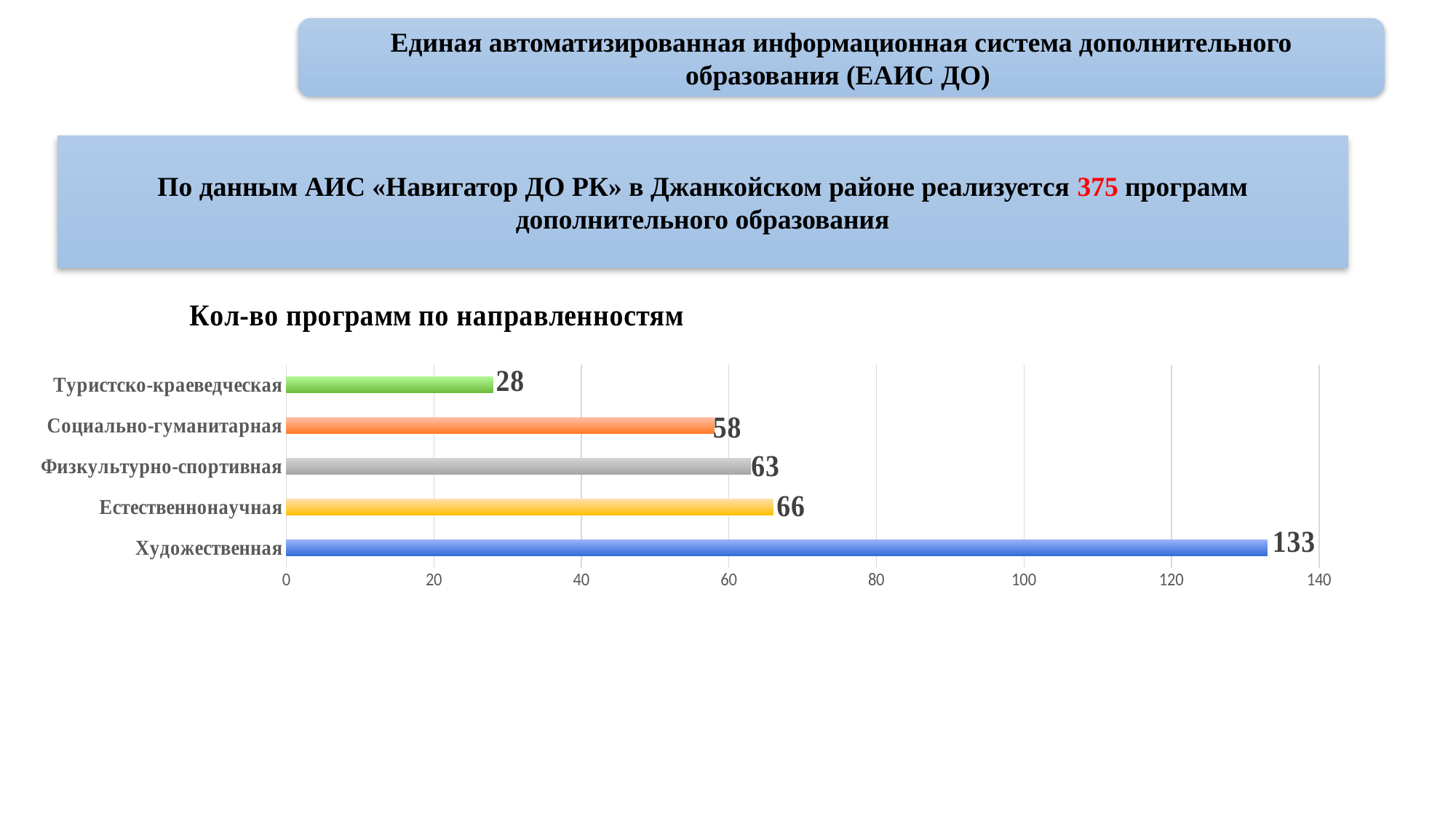
What is the value for Художественная? 133 Which category has the highest value? Художественная What is the difference between the values for Физкультурно-спортивная and Социально-гуманитарная? 5 What is the value for Естественнонаучная? 66 What is the value for Социально-гуманитарная? 58 What is the value for Туристско-краеведческая? 28 What is the difference between the values for Художественная and Естественнонаучная? 67 What is the title of the chart? Кол-во программ по направленностям Which is larger, the value for Естественнонаучная or the value for Физкультурно-спортивная? Естественнонаучная Which category has the lowest value? Туристско-краеведческая What kind of chart is shown on the slide? bar chart How many categories are shown in the chart? 5